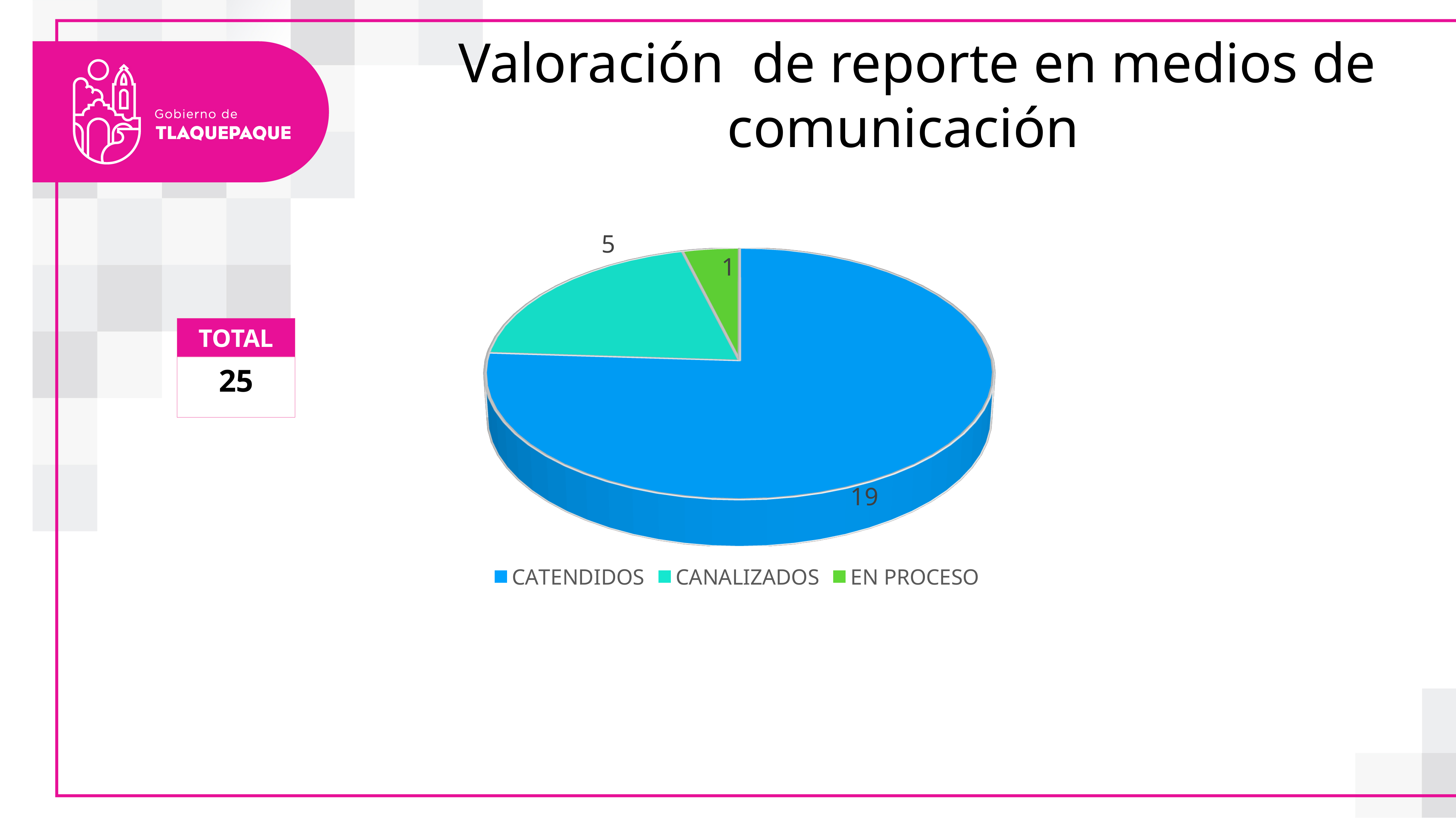
What is the value for CANALIZADOS? 5 What share of the pie does CATENDIDOS represent? 76% What is the value for CATENDIDOS? 19 What is the difference between the values for CATENDIDOS and CANALIZADOS? 14 Which category has the smallest slice? EN PROCESO What colour is the CANALIZADOS slice? teal Which category has the largest slice? CATENDIDOS What kind of chart is shown on the slide? pie chart How many categories does the pie chart show? 3 What is the total of all slices in the pie chart? 25 Which is larger, CANALIZADOS or EN PROCESO? CANALIZADOS What is the value for EN PROCESO? 1